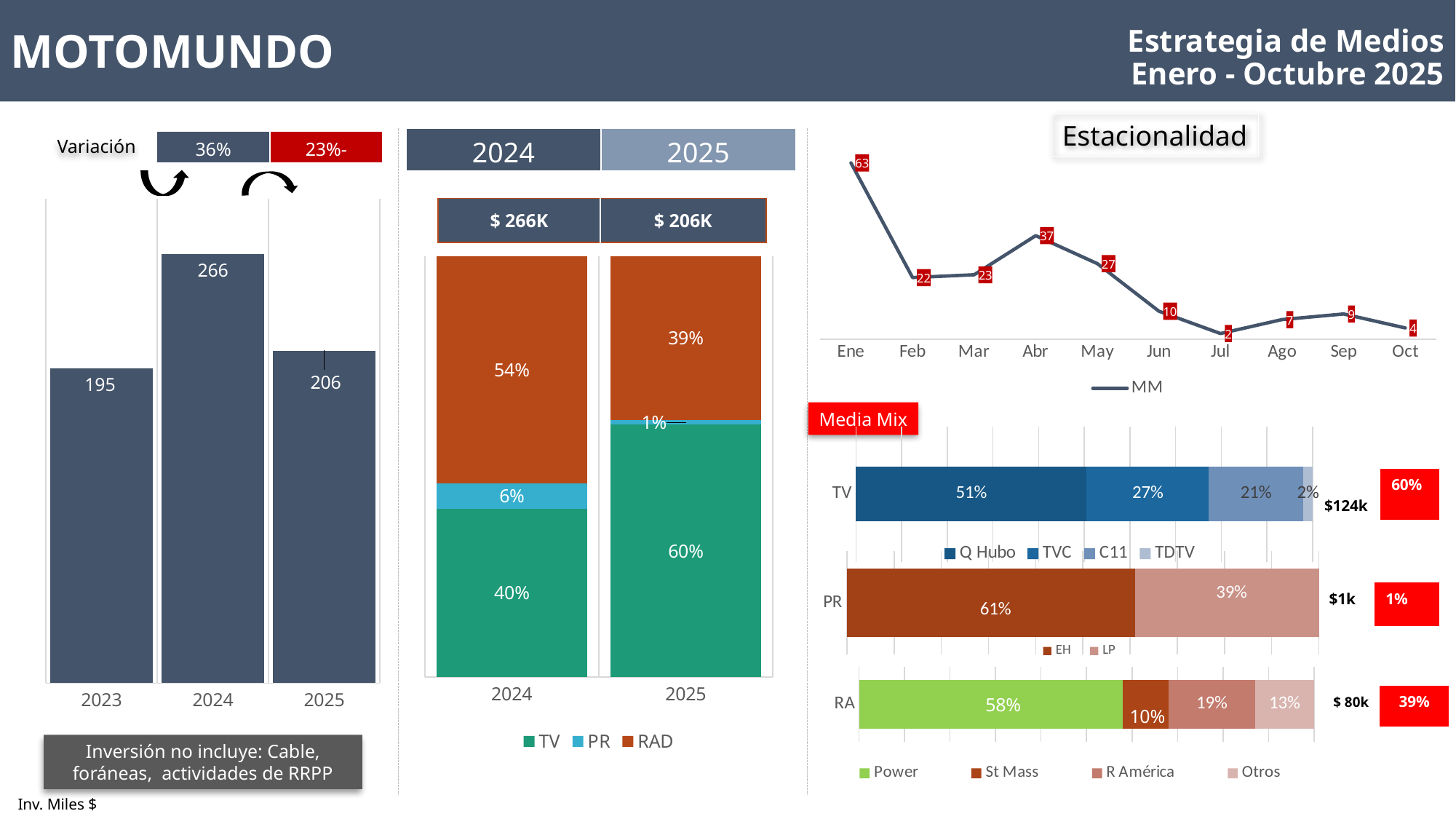
In the Estacionalidad line chart, which month has the highest value? Ene In the stacked bar chart in the middle, what share does TV have in 2025? 60% In the stacked bar chart in the middle, what share does RAD have in 2024? 54% In the bar chart on the left, what is the value for 2024? 266 In the Estacionalidad line chart, which month has the lowest value? Jul In the Estacionalidad line chart, what is the value for Abr? 37 In the bar chart on the left, how many years are shown? 3 In the bar chart on the left, which year has the lowest value? 2023 In the stacked bar chart in the middle, how many series does the legend list? 3 In the Media Mix chart, what share does Power have in the RA bar? 58% In the Media Mix chart, what share does Q Hubo have in the TV bar? 51% In the bar chart on the left, what is the difference between the 2024 and 2025 values? 60